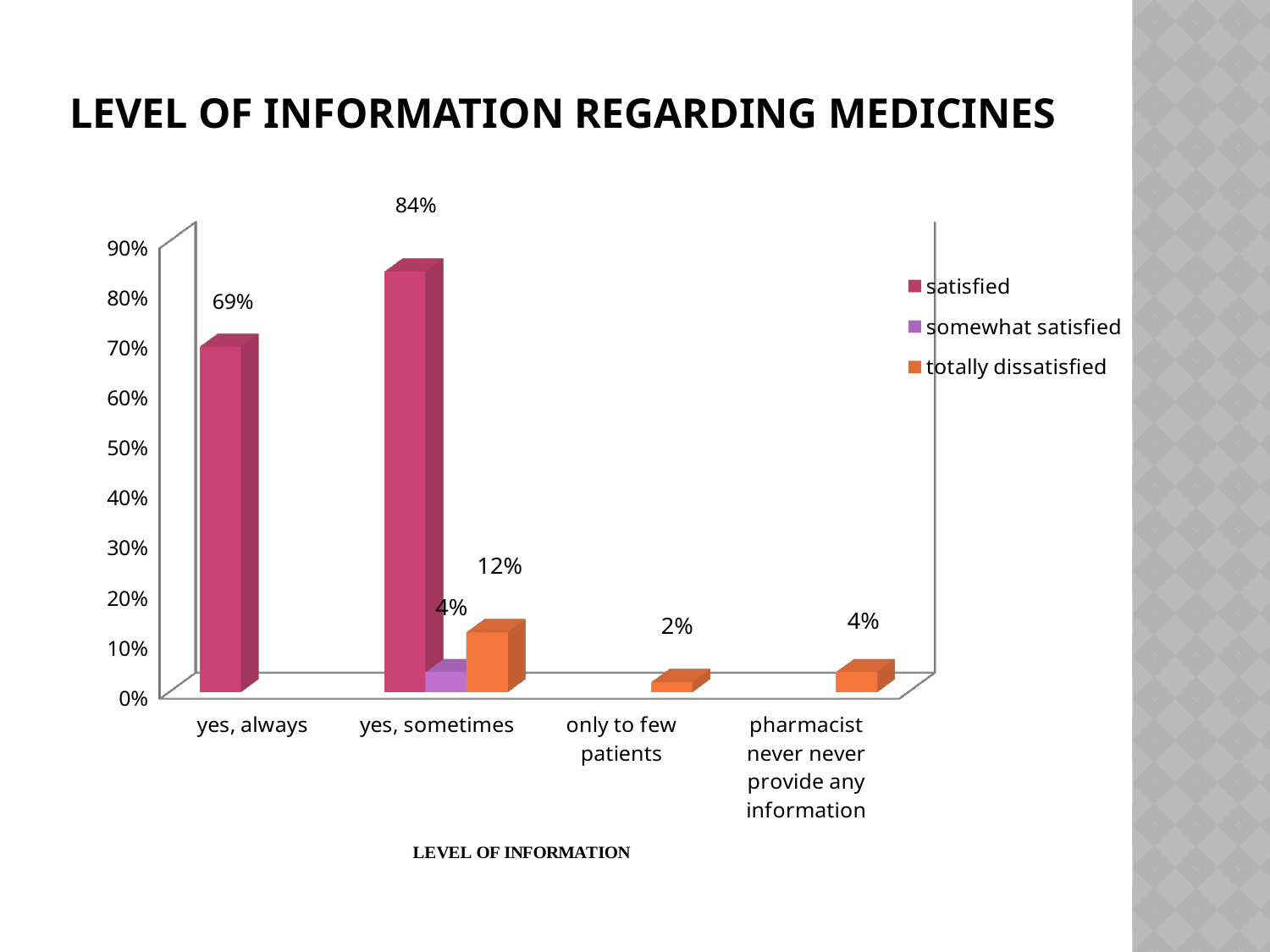
What is the difference between the satisfied values for 'yes, sometimes' and 'yes, always'? 15% Which category has the lowest totally dissatisfied value? only to few patients Which is larger: the totally dissatisfied value for 'yes, sometimes' or for 'pharmacist never never provide any information'? yes, sometimes How many series does the legend list? 3 What is the value for totally dissatisfied in the 'yes, sometimes' category? 12% How many categories are shown on the x axis? 4 Which category has the highest satisfied value? yes, sometimes What is the value for satisfied in the 'yes, always' category? 69% What kind of chart is shown on the slide? bar chart What is the value for satisfied in the 'yes, sometimes' category? 84% What is the x-axis title of the chart? LEVEL OF INFORMATION What is the value for totally dissatisfied in the 'only to few patients' category? 2%